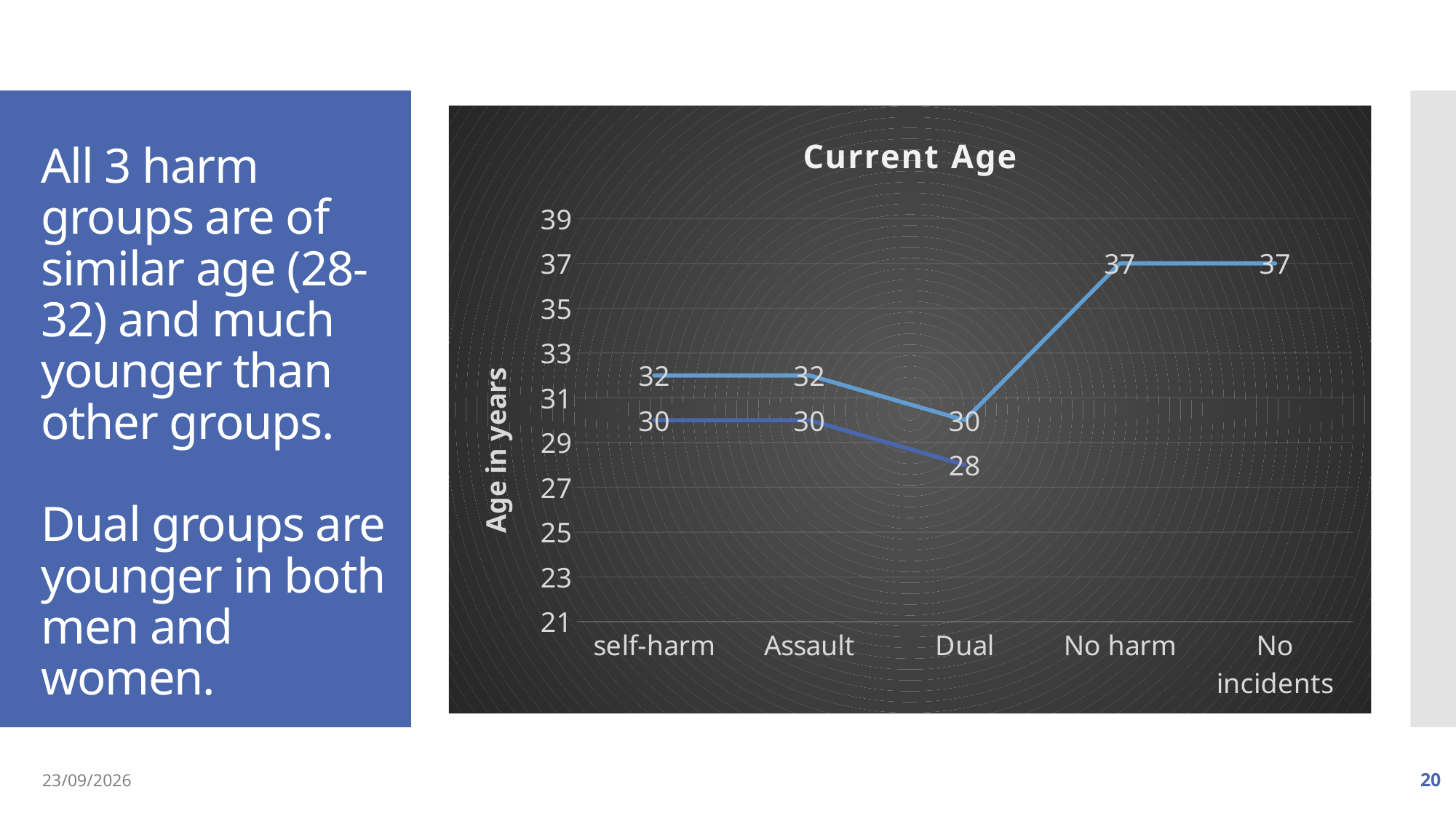
What is the title of the chart? Current Age What is the difference between the lighter blue line's values for No harm and Dual? 7 What is the value of the lighter blue line for No harm? 37 Which is larger on the lighter blue line: the value for self-harm or the value for Dual? self-harm What is the value of the lighter blue line for Dual? 30 Does the lighter blue line rise or fall between Dual and No harm? rise For which category is the lighter blue line at its lowest value? Dual What is the label on the vertical axis of the chart? Age in years How many lines are plotted on the chart? 2 How many categories are shown along the x axis of the chart? 5 What kind of chart is shown on the slide? line chart What is the value of the darker blue line for Dual? 28